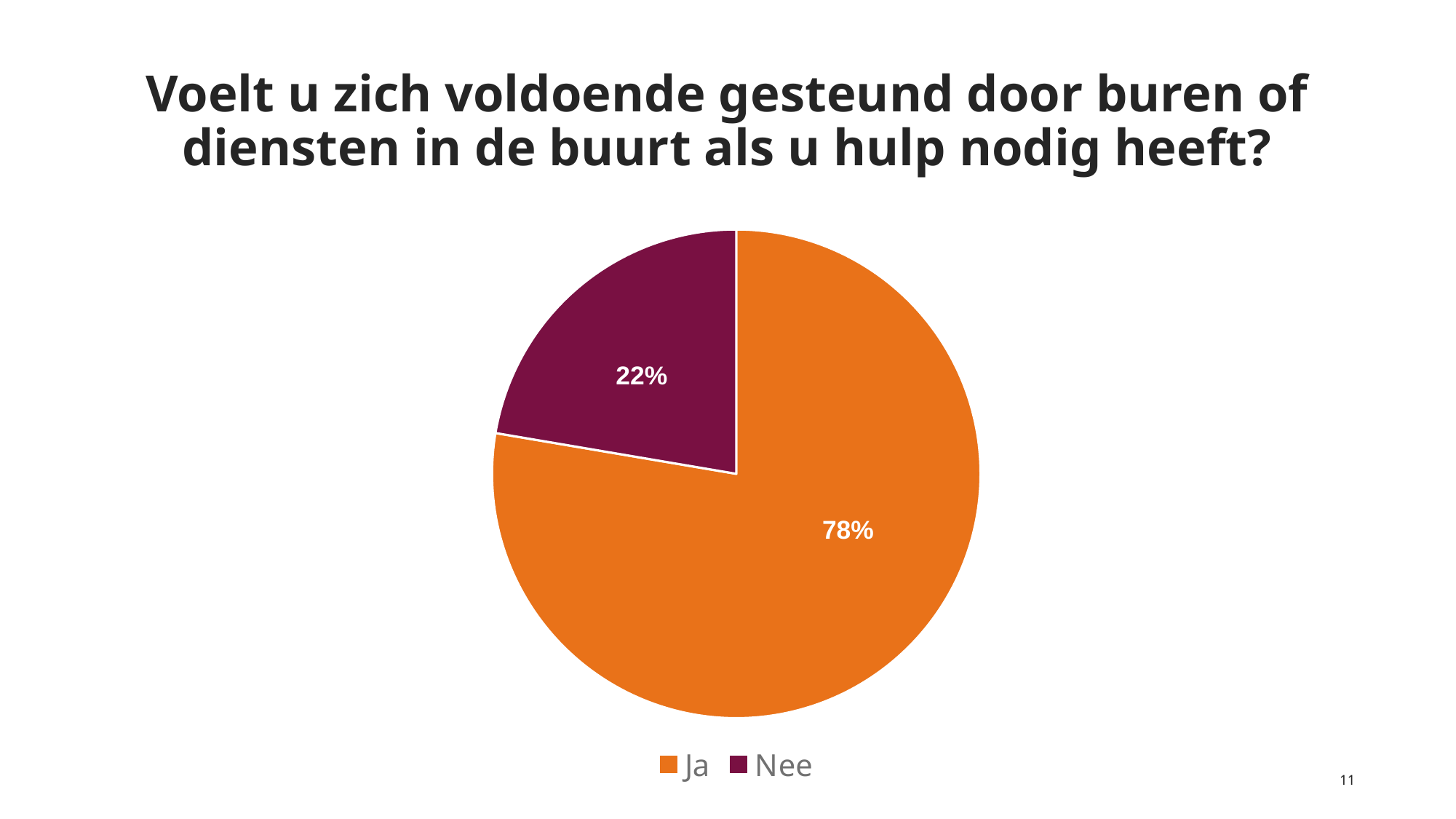
What percentage of respondents answered "Nee"? 22% What share of the pie does the "Nee" slice represent? 22% What is the title of the chart? Voelt u zich voldoende gesteund door buren of diensten in de buurt als u hulp nodig heeft? Which answer has the largest share of the pie? Ja What is the difference in percentage points between the "Ja" and "Nee" slices? 56 What colour is the "Ja" slice? orange What kind of chart is shown on the slide? pie chart How many slices does the pie chart have? 2 What percentage of respondents answered "Ja"? 78% Which slice is larger, "Ja" or "Nee"? Ja Which answer has the smallest share of the pie? Nee How many entries does the legend list? 2